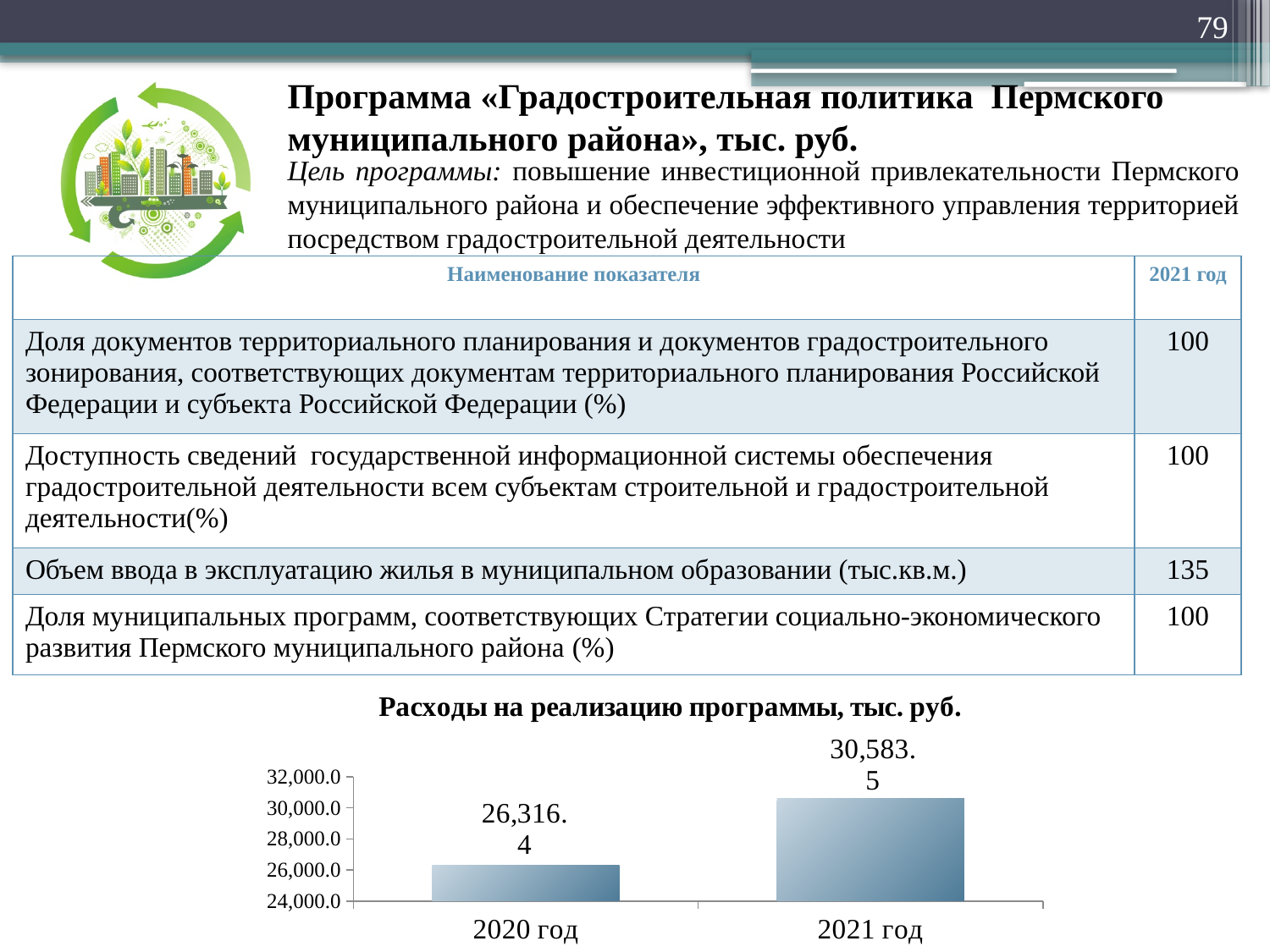
Which year has the highest value in the chart 'Расходы на реализацию программы, тыс. руб.'? 2021 год In the chart 'Расходы на реализацию программы, тыс. руб.', is the value for 2021 год greater or less than 30,000.0? greater In the chart 'Расходы на реализацию программы, тыс. руб.', which is larger: the value for 2020 год or for 2021 год? 2021 год In the chart 'Расходы на реализацию программы, тыс. руб.', is the value for 2020 год greater or less than 28,000.0? less What is the title of the chart at the bottom of the slide? Расходы на реализацию программы, тыс. руб. How many categories are shown in the chart 'Расходы на реализацию программы, тыс. руб.'? 2 What is the value for 2021 год in the chart 'Расходы на реализацию программы, тыс. руб.'? 30,583.5 Do the values in the chart 'Расходы на реализацию программы, тыс. руб.' rise or fall from 2020 год to 2021 год? rise Which year has the lowest value in the chart 'Расходы на реализацию программы, тыс. руб.'? 2020 год What is the difference between the values for 2021 год and 2020 год in the chart 'Расходы на реализацию программы, тыс. руб.'? 4,267.1 What is the value for 2020 год in the chart 'Расходы на реализацию программы, тыс. руб.'? 26,316.4 What kind of chart is 'Расходы на реализацию программы, тыс. руб.'? bar chart